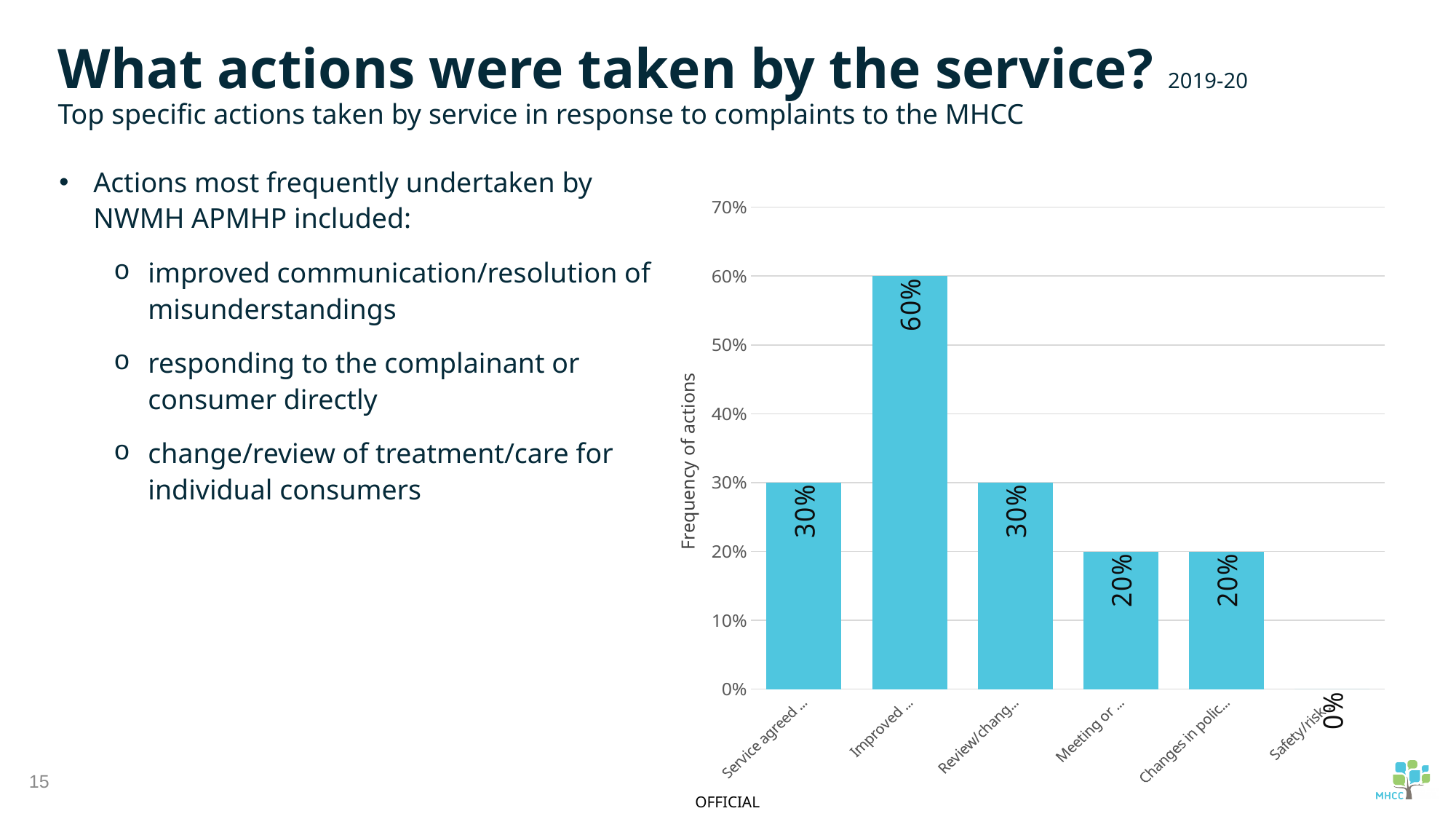
What is the value shown for the category labelled 'Safety/risk...'? 0% Is the value for 'Improved ...' greater or less than 50%? greater How many bars (categories) are plotted in the chart? 6 What is the value of the bar labelled 'Service agreed ...'? 30% What is the value of the bar labelled 'Improved ...'? 60% Which category has the lowest frequency of actions? Safety/risk... Which is larger, the value for 'Changes in polic...' or the value for 'Service agreed ...'? Service agreed ... What is the label on the vertical axis of the chart? Frequency of actions What is the value of the bar labelled 'Meeting or ...'? 20% What kind of chart is shown on the slide? bar chart What is the difference between the value for 'Improved ...' and the value for 'Review/chang...'? 30% Which category has the highest frequency of actions? Improved ...